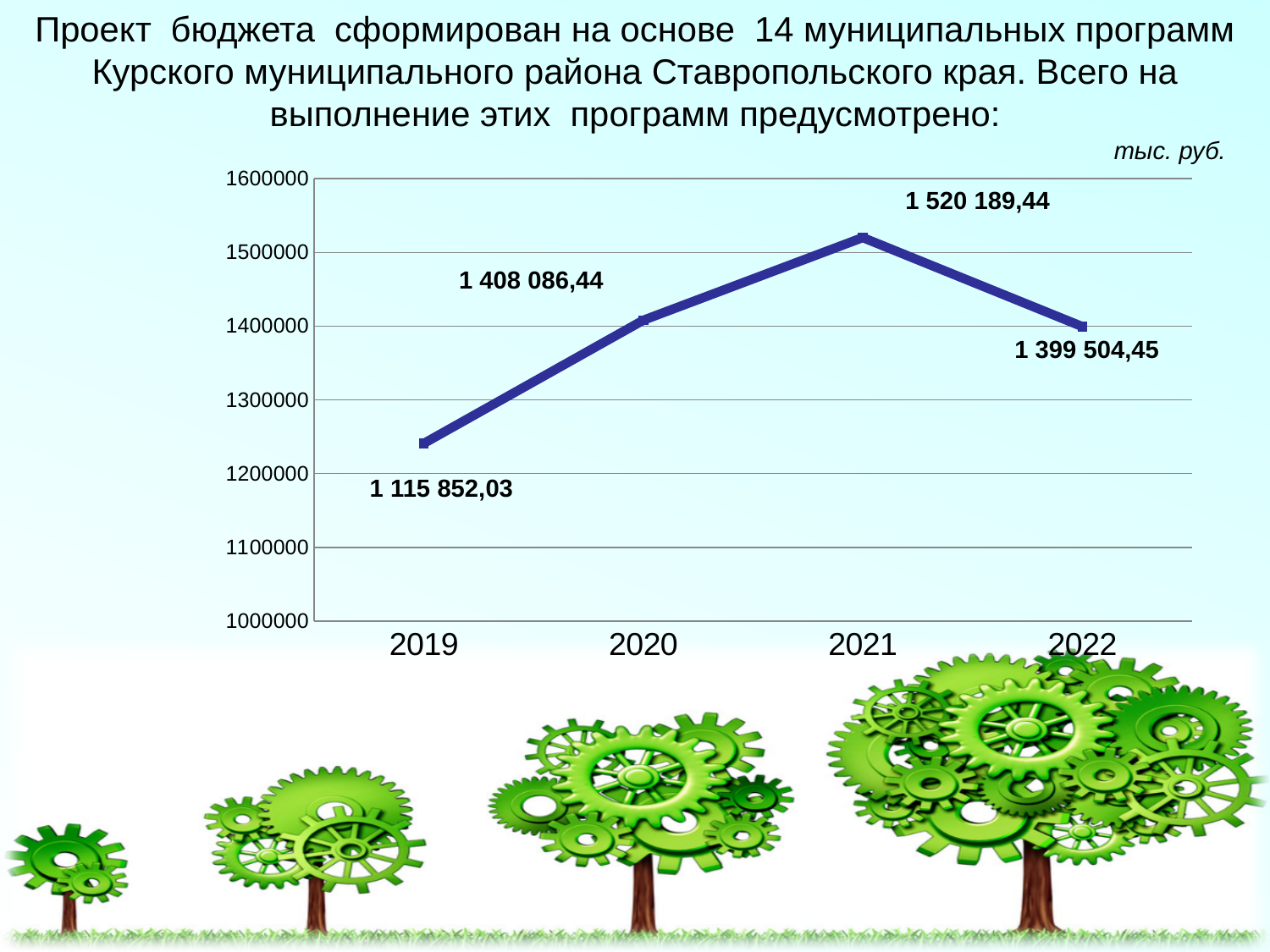
What is the value for 2021? 1 520 189,44 Which year has the highest value? 2021 What is the value for 2020? 1 408 086,44 How many years are plotted on the chart? 4 Which year has the lowest value? 2019 What is the difference between the values for 2021 and 2022? 120 684,99 What type of chart is shown on the slide? line chart Which is larger, the value for 2020 or the value for 2022? 2020 What unit is indicated above the chart? тыс. руб. What is the value for 2019? 1 115 852,03 What is the value for 2022? 1 399 504,45 What is the difference between the values for 2021 and 2020? 112 103,00